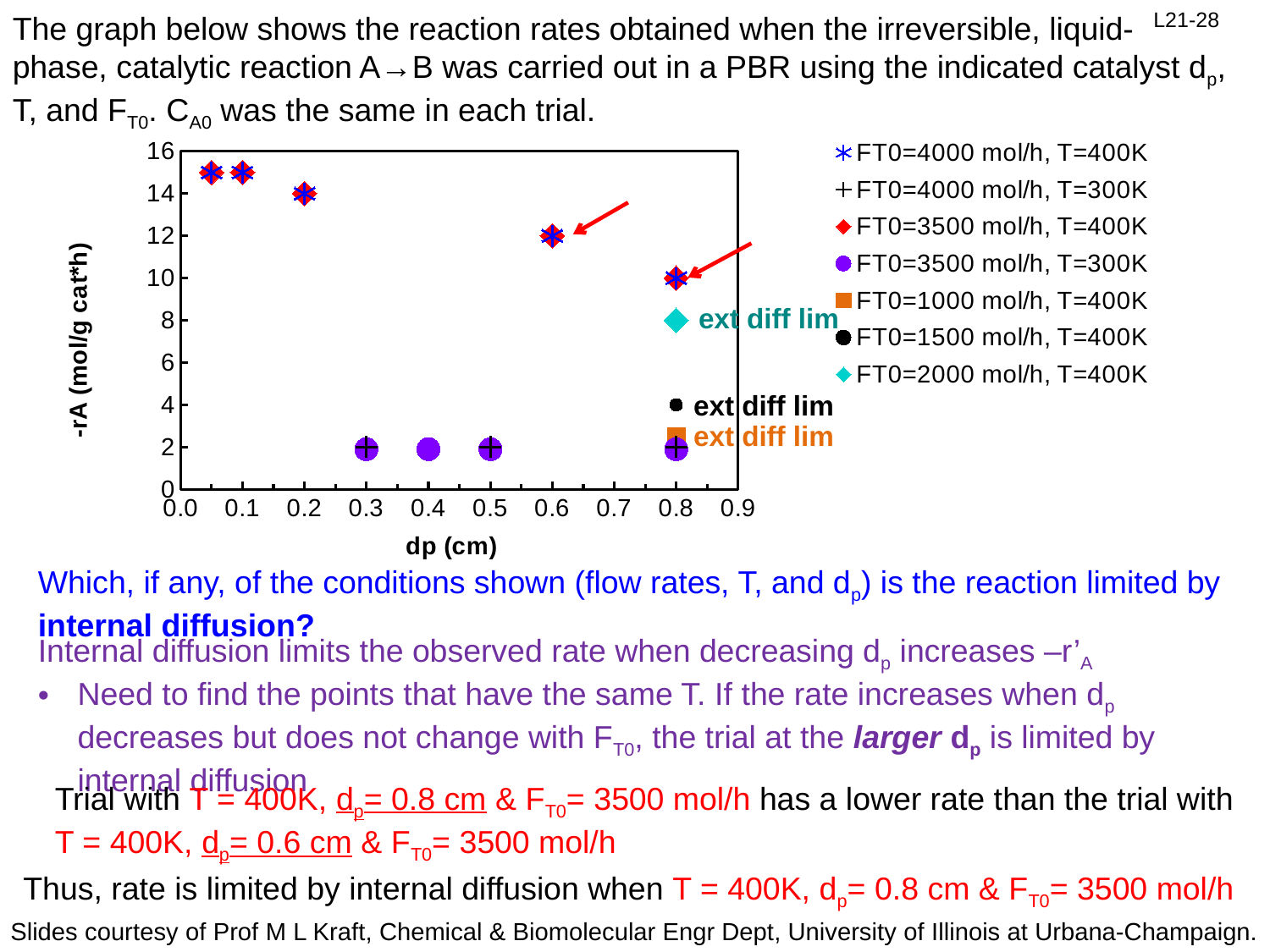
How many series does the chart legend list? 7 Which has the higher reaction rate at dp = 0.8 cm: the FT0=3500 mol/h, T=400K trial or the FT0=3500 mol/h, T=300K trial? FT0=3500 mol/h, T=400K For the T=400K trials, does the reaction rate rise or fall as dp increases from 0.05 cm to 0.8 cm? fall What is the reaction rate -rA for the FT0=3500 mol/h, T=400K trial at dp = 0.6 cm? 12 What is the label of the y axis of the chart? -rA (mol/g cat*h) What is the reaction rate -rA for the FT0=3500 mol/h, T=400K trial at dp = 0.8 cm? 10 What is the reaction rate -rA for the T=400K trials at dp = 0.2 cm? 14 What kind of chart is shown on the slide? scatter chart Is the reaction rate for the T=400K trials at dp = 0.1 cm greater or less than 14? greater Is the reaction rate for the FT0=2000 mol/h, T=400K point at dp = 0.8 cm greater or less than 10? less What is the label of the x axis of the chart? dp (cm)